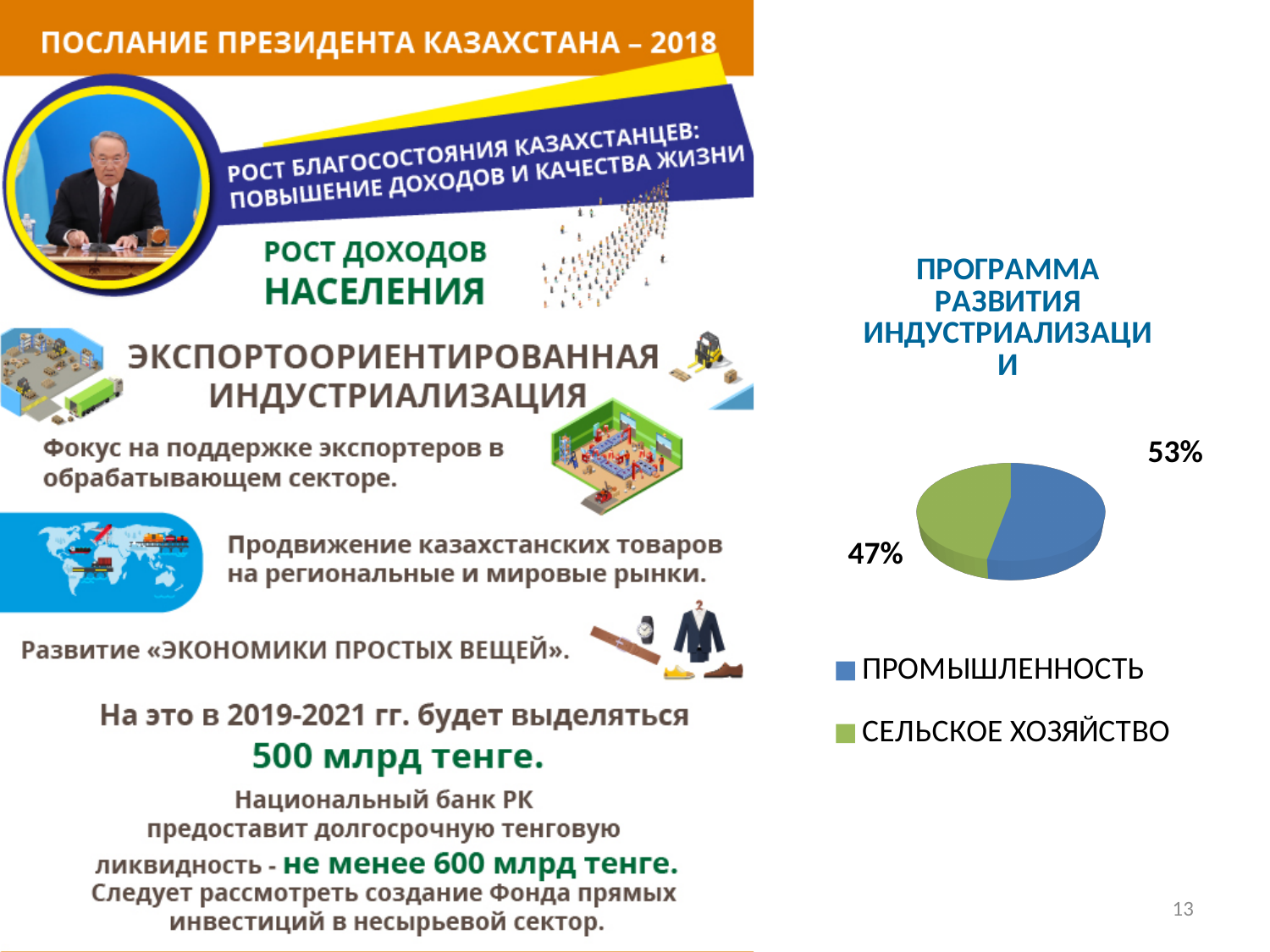
What share of the pie does ПРОМЫШЛЕННОСТЬ have? 53% Which is larger, the share of ПРОМЫШЛЕННОСТЬ or the share of СЕЛЬСКОЕ ХОЗЯЙСТВО? ПРОМЫШЛЕННОСТЬ How many entries does the chart legend list? 2 Which category has the largest slice of the pie? ПРОМЫШЛЕННОСТЬ Which category has the smallest slice of the pie? СЕЛЬСКОЕ ХОЗЯЙСТВО What kind of chart is shown on the slide? pie chart Which colour represents СЕЛЬСКОЕ ХОЗЯЙСТВО in the pie chart? green How many slices does the pie chart have? 2 What share of the pie does СЕЛЬСКОЕ ХОЗЯЙСТВО have? 47% What is the title of the pie chart? ПРОГРАММА РАЗВИТИЯ ИНДУСТРИАЛИЗАЦИИ What is the difference between the shares of ПРОМЫШЛЕННОСТЬ and СЕЛЬСКОЕ ХОЗЯЙСТВО? 6% Is the share of ПРОМЫШЛЕННОСТЬ greater or less than 50%? greater